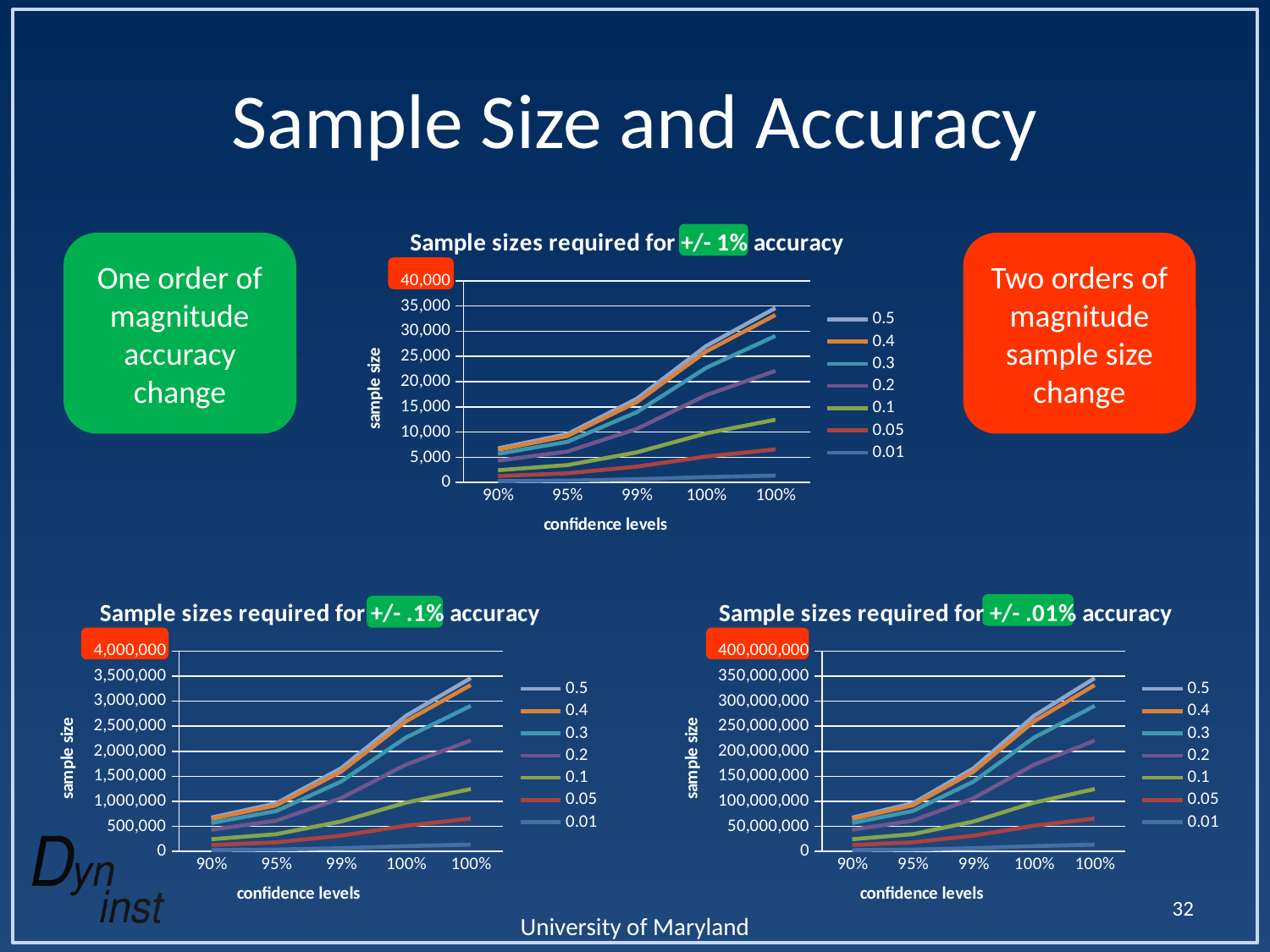
What is the highest y-axis tick shown on "Sample sizes required for +/- .01% accuracy"? 400,000,000 In "Sample sizes required for +/- .1% accuracy", which is larger at the final 100% confidence level: the 0.3 series or the 0.1 series? 0.3 In "Sample sizes required for +/- .01% accuracy", is the value of the 0.05 series at the final 100% confidence level greater or less than 50,000,000? greater What kind of chart is "Sample sizes required for +/- 1% accuracy"? line chart What is the y-axis label on "Sample sizes required for +/- .01% accuracy"? sample size In "Sample sizes required for +/- .1% accuracy", is the value of the 0.5 series at the final 100% confidence level greater or less than 3,000,000? greater How many series does the legend of "Sample sizes required for +/- 1% accuracy" list? 7 In "Sample sizes required for +/- 1% accuracy", is the value of the 0.01 series at the final 100% confidence level greater or less than 5,000? less In "Sample sizes required for +/- 1% accuracy", do the sample sizes rise or fall as the confidence level increases along the x axis? rise In "Sample sizes required for +/- .01% accuracy", which series has the lowest sample sizes across all confidence levels? 0.01 How many confidence levels are plotted along the x axis of "Sample sizes required for +/- .1% accuracy"? 5